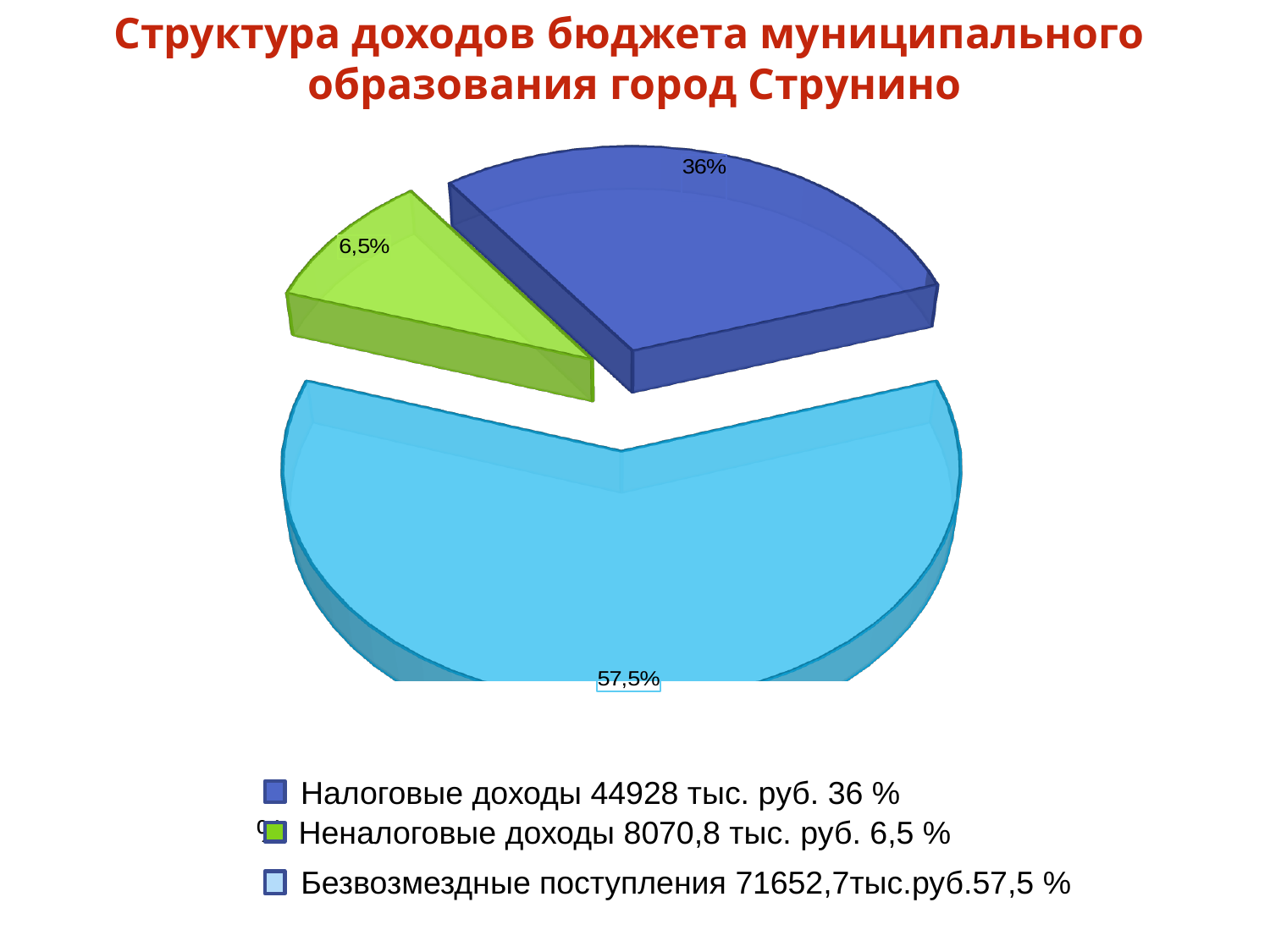
What share of the pie does Налоговые доходы represent? 36% Which category has the largest slice of the pie? Безвозмездные поступления Which is larger: the Налоговые доходы slice or the Неналоговые доходы slice? Налоговые доходы What is the difference in percentage points between the Безвозмездные поступления slice and the Налоговые доходы slice? 21,5 Which category has the smallest slice of the pie? Неналоговые доходы What share of the pie does Безвозмездные поступления represent? 57,5% How many entries does the legend list? 3 What colour is the Неналоговые доходы slice? green What share of the pie does Неналоговые доходы represent? 6,5% What kind of chart is shown on the slide? pie chart What amount in тыс. руб. does the legend give for Налоговые доходы? 44928 тыс. руб. How many slices does the pie chart have? 3